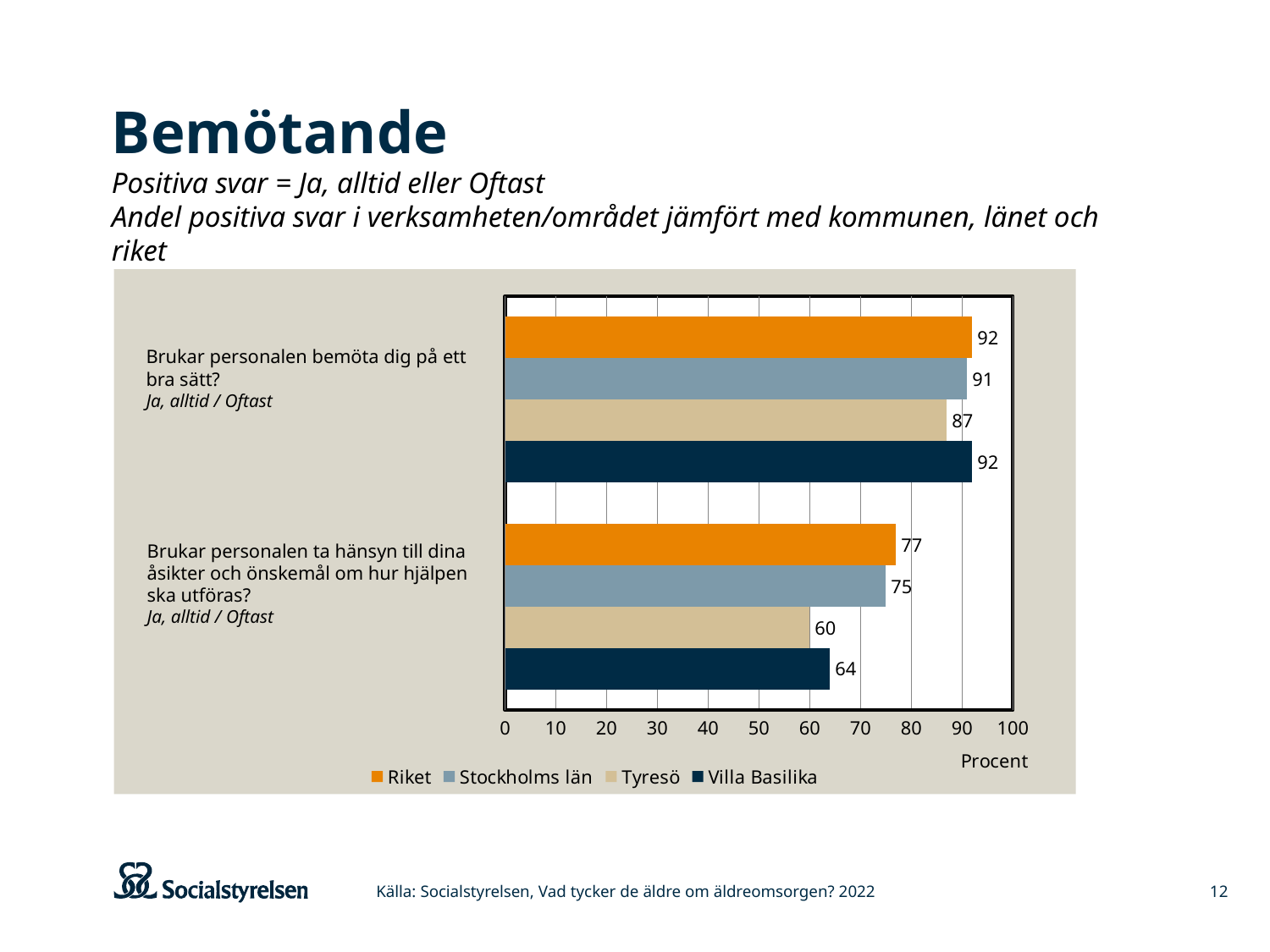
What is the value for Tyresö on the question "Brukar personalen ta hänsyn till dina åsikter och önskemål om hur hjälpen ska utföras?"? 60 What is the value for Villa Basilika on the question "Brukar personalen ta hänsyn till dina åsikter och önskemål om hur hjälpen ska utföras?"? 64 What kind of chart is shown on the slide? Bar chart How many series does the legend list? 4 What is the difference between Villa Basilika and Tyresö on the question "Brukar personalen bemöta dig på ett bra sätt?"? 5 What is the value for Stockholms län on the question "Brukar personalen bemöta dig på ett bra sätt?"? 91 Which series has the lowest value on the question "Brukar personalen ta hänsyn till dina åsikter och önskemål om hur hjälpen ska utföras?"? Tyresö Which is larger on the question "Brukar personalen ta hänsyn till dina åsikter och önskemål om hur hjälpen ska utföras?": Villa Basilika or Tyresö? Villa Basilika Which series has the lowest value on the question "Brukar personalen bemöta dig på ett bra sätt?"? Tyresö What is the difference between Riket and Tyresö on the question "Brukar personalen ta hänsyn till dina åsikter och önskemål om hur hjälpen ska utföras?"? 17 What is the value for Riket on the question "Brukar personalen bemöta dig på ett bra sätt?"? 92 What is the label of the x axis? Procent